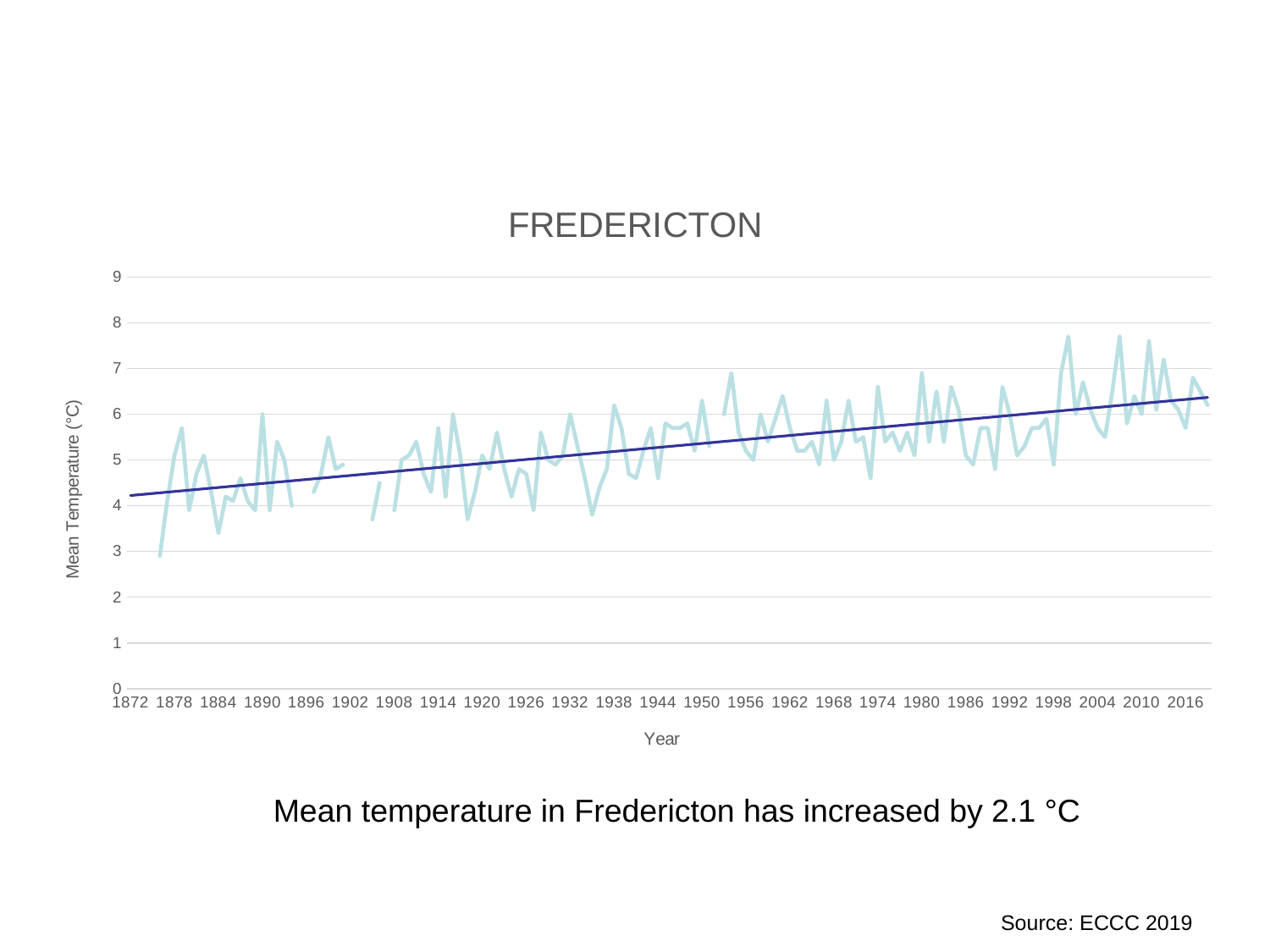
Is the value of the trend line at 1872 greater or less than 3? greater What kind of chart is shown on the slide? line chart Is the value of the trend line at 2016 greater or less than 8? less What is the title of the chart? FREDERICTON Is the value of the trend line at 1872 greater or less than 5? less What is the label on the vertical axis of the chart? Mean Temperature (°C) Does the trend line rise or fall from 1872 to 2016? rises